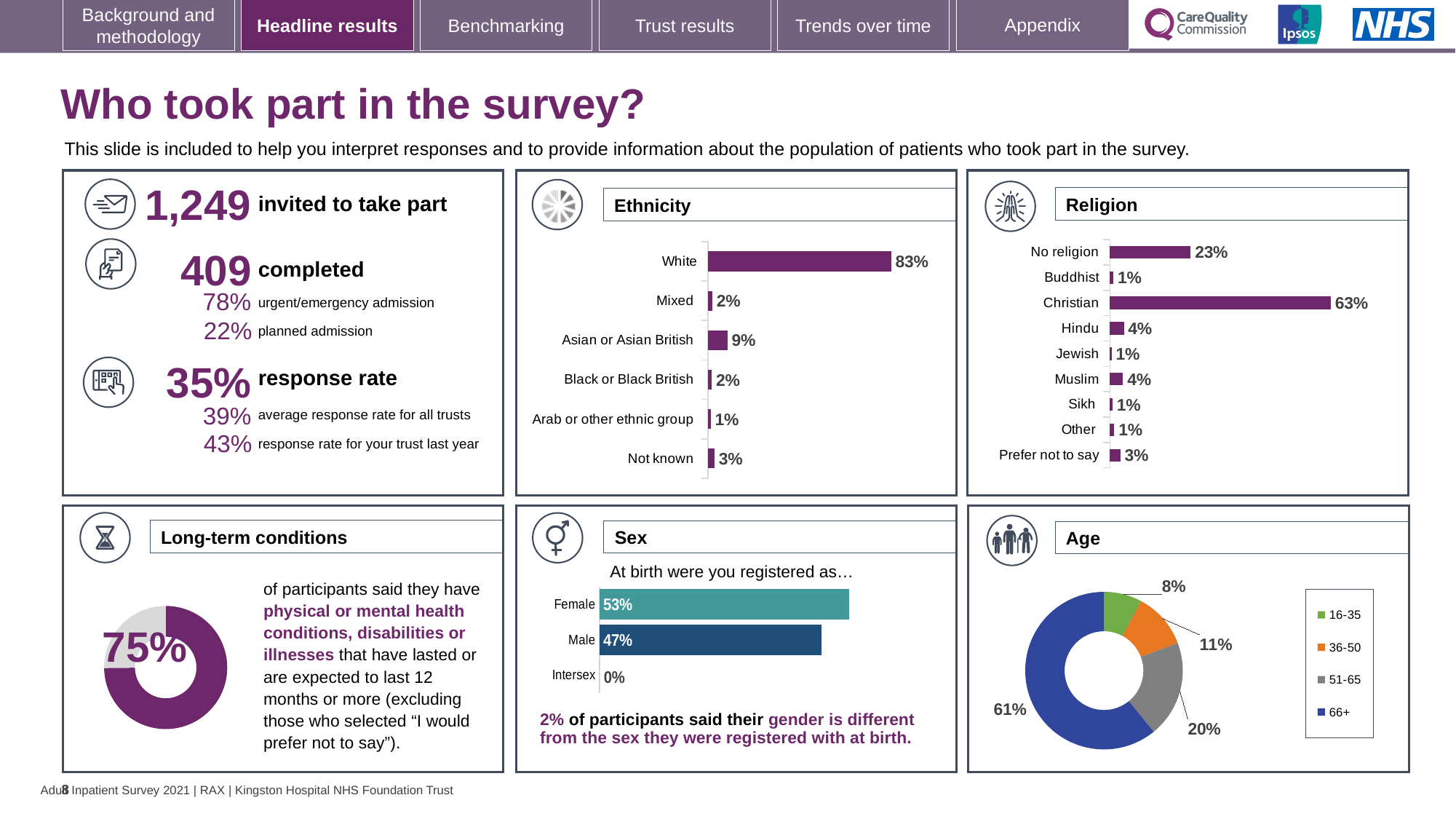
In the Religion chart, which is larger, the value for Hindu or the value for Prefer not to say? Hindu What kind of chart is used in the Age panel? Donut (pie) chart In the Ethnicity chart, which category has the lowest value? Arab or other ethnic group In the Ethnicity chart, what percentage of participants were White? 83% In the Sex chart, what percentage of participants were registered as Male at birth? 47% In the Religion chart, which category has the highest value? Christian How many categories are shown in the Religion chart? 9 How many entries does the legend of the Age chart list? 4 In the Age chart, what share of participants were aged 66+? 61% How many categories are shown in the Ethnicity chart? 6 In the Religion chart, what percentage of participants said they had no religion? 23% In the Ethnicity chart, what is the difference between the values for Asian or Asian British and Mixed? 7 percentage points